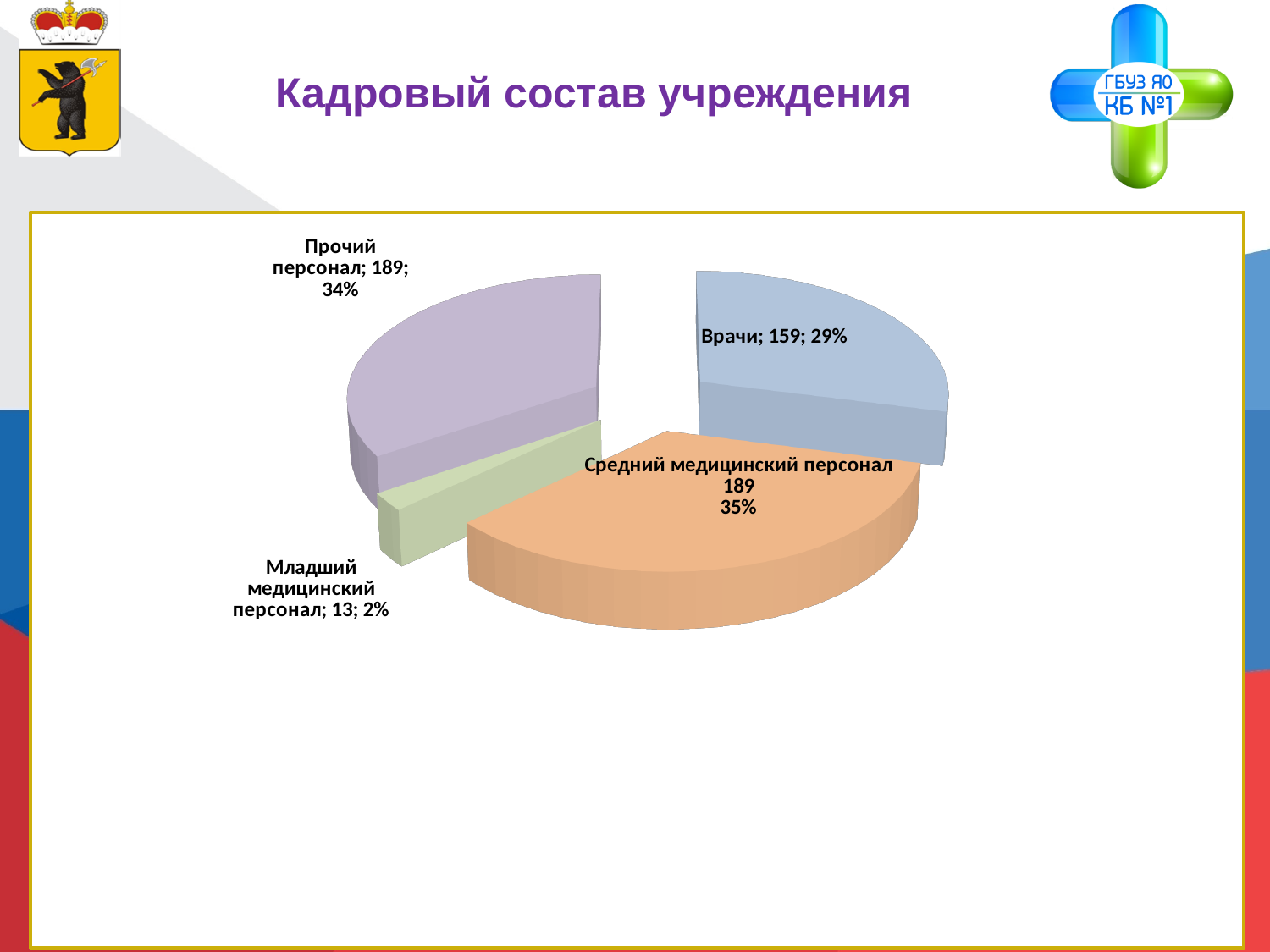
How many people are in the category Младший медицинский персонал? 13 What share of the pie does Средний медицинский персонал represent? 35% How many categories (slices) does the pie chart have? 4 Which category has the smallest slice of the pie? Младший медицинский персонал What is the difference between the values for Средний медицинский персонал and Младший медицинский персонал? 176 How many people are in the category Врачи? 159 What is the title of the chart on the slide? Кадровый состав учреждения What is the difference between the values for Прочий персонал and Врачи? 30 What share of the pie does Врачи represent? 29% What kind of chart is shown on the slide? Pie chart How many people are in the category Прочий персонал? 189 Which is larger, the value for Врачи or the value for Прочий персонал? Прочий персонал